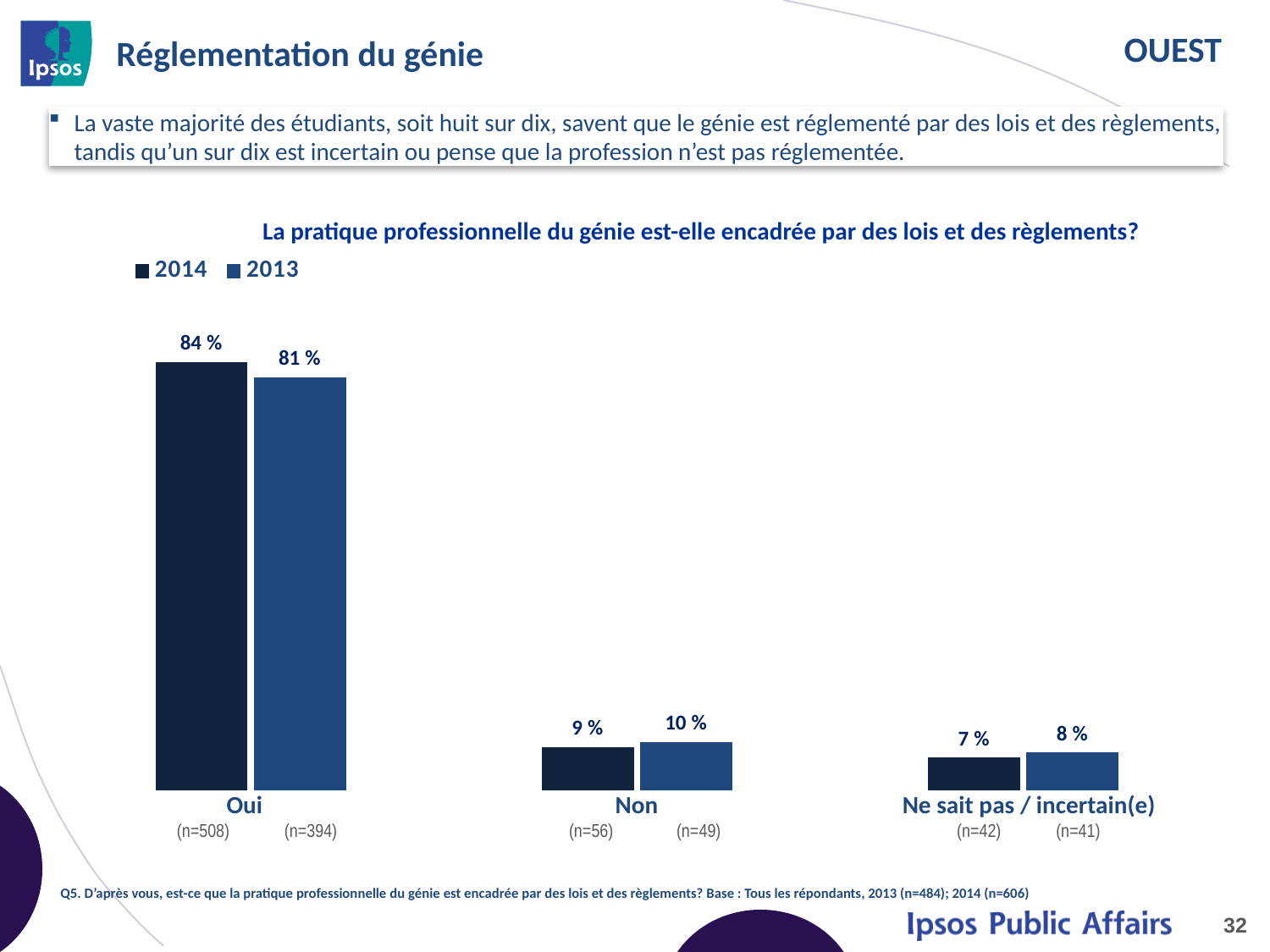
What kind of chart is shown on the slide? Bar chart What is the title of the chart? La pratique professionnelle du génie est-elle encadrée par des lois et des règlements? Which category has the lowest value in the 2013 series? Ne sait pas / incertain(e) How many categories are shown on the x axis? 3 Which category has the highest value in the 2014 series? Oui What is the value for "Non" in the 2014 series? 9 % How many series does the legend list? 2 Which is larger for "Non": the 2014 value or the 2013 value? 2013 What is the value for "Oui" in the 2013 series? 81 % What is the value for "Ne sait pas / incertain(e)" in the 2013 series? 8 % What is the value for "Oui" in the 2014 series? 84 % What is the difference between the 2014 and 2013 values for "Oui"? 3 %